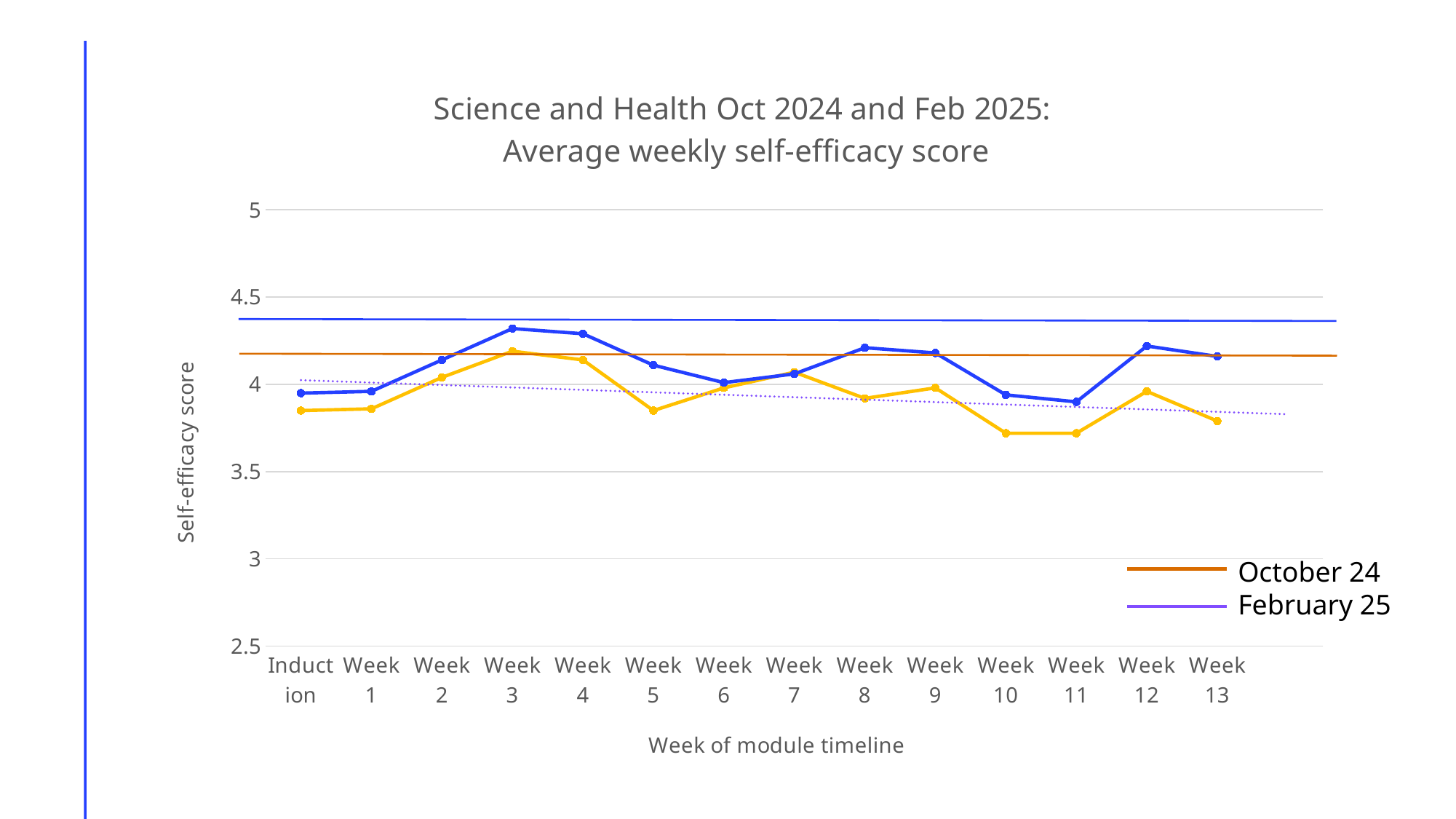
What is the title of the chart? Science and Health Oct 2024 and Feb 2025: Average weekly self-efficacy score At Week 10, which line has the higher value, the blue line or the yellow line? the blue line What is the label of the y axis? Self-efficacy score At Week 3, which line has the higher value, the blue line or the yellow line? the blue line Is the value of the blue line at Week 11 greater or less than 4? less Is the value of the blue line at Week 3 greater or less than 4? greater How many categories are shown along the x axis? 14 How many series does the legend list? 2 Is the value of the yellow line at Week 10 greater or less than 4? less What kind of chart is shown on the slide? line chart Does the yellow line rise or fall from Week 9 to Week 10? fall